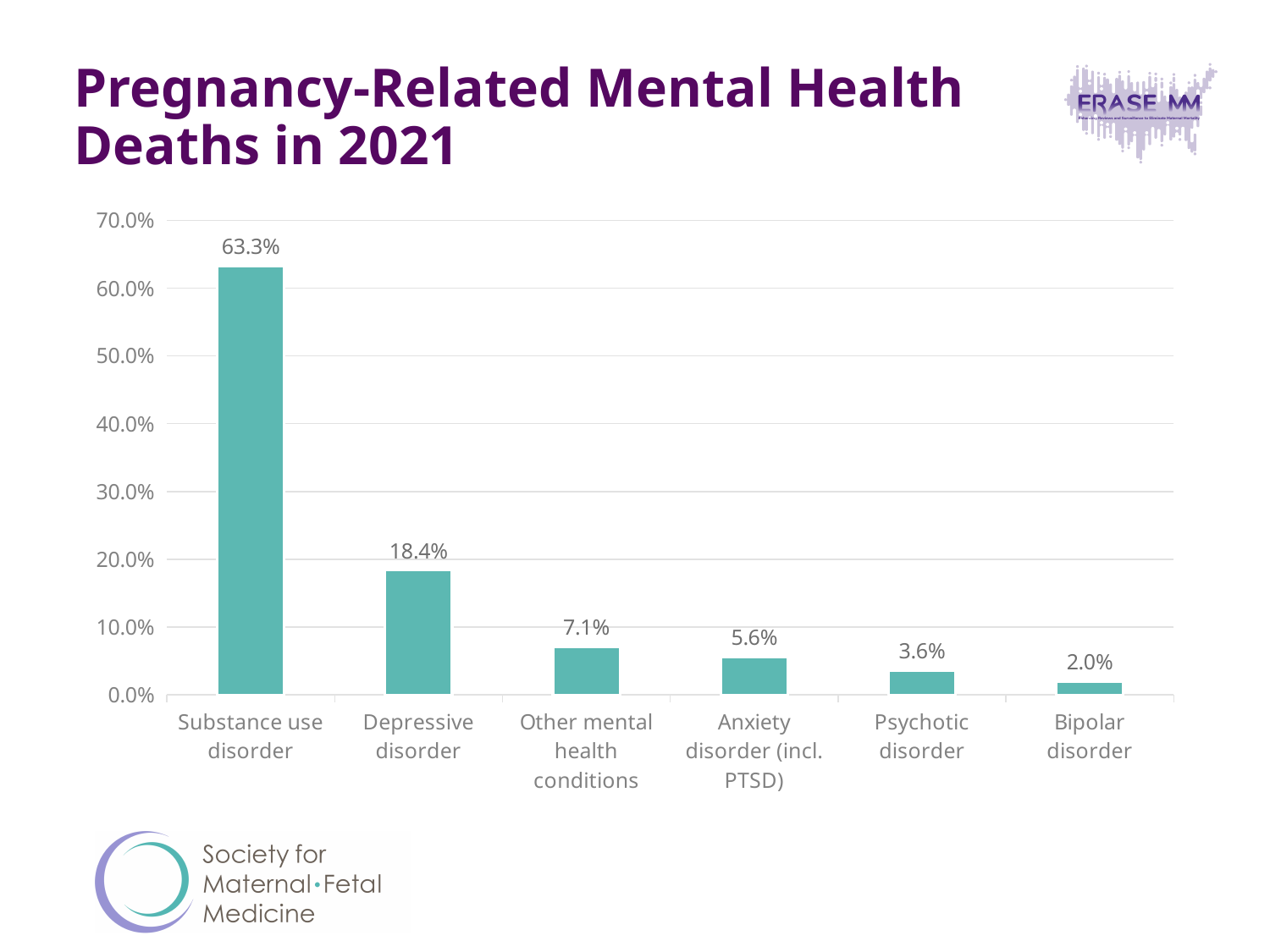
Which is larger, the value for Other mental health conditions or the value for Anxiety disorder (incl. PTSD)? Other mental health conditions What is the difference between the values for Other mental health conditions and Psychotic disorder? 3.5% What is the value for Bipolar disorder? 2.0% What is the value for Depressive disorder? 18.4% What kind of chart is shown on the slide? Bar chart What is the difference between the values for Substance use disorder and Depressive disorder? 44.9% Which category has the lowest value? Bipolar disorder Which category has the highest value? Substance use disorder What is the value for Anxiety disorder (incl. PTSD)? 5.6% How many categories are shown on the chart? 6 Do the values rise or fall from left to right along the x axis? Fall What is the value for Substance use disorder? 63.3%